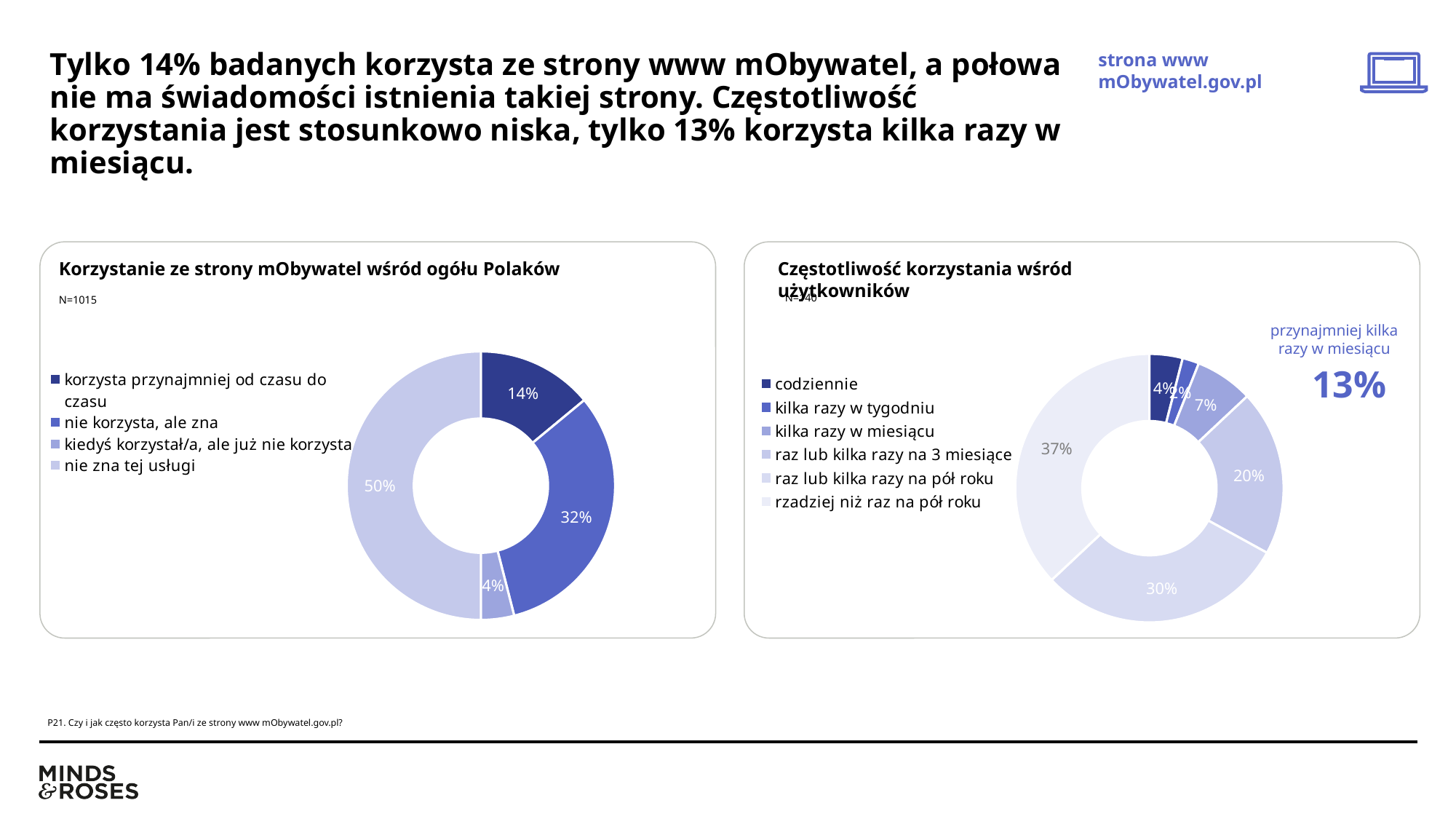
In the chart 'Korzystanie ze strony mObywatel wśród ogółu Polaków', what is the difference between 'nie korzysta, ale zna' and 'korzysta przynajmniej od czasu do czasu'? 18 percentage points How many categories does the legend of the chart 'Częstotliwość korzystania wśród użytkowników' list? 6 In the chart 'Korzystanie ze strony mObywatel wśród ogółu Polaków', what is the value for 'nie korzysta, ale zna'? 32% In the chart 'Częstotliwość korzystania wśród użytkowników', what is the value for 'rzadziej niż raz na pół roku'? 37% In the chart 'Częstotliwość korzystania wśród użytkowników', what is the value for 'raz lub kilka razy na 3 miesiące'? 20% In the chart 'Korzystanie ze strony mObywatel wśród ogółu Polaków', which category has the smallest share? kiedyś korzystał/a, ale już nie korzysta In the chart 'Korzystanie ze strony mObywatel wśród ogółu Polaków', what share of respondents 'nie zna tej usługi'? 50% In the chart 'Częstotliwość korzystania wśród użytkowników', which is larger: 'raz lub kilka razy na pół roku' or 'raz lub kilka razy na 3 miesiące'? raz lub kilka razy na pół roku How many categories does the legend of the chart 'Korzystanie ze strony mObywatel wśród ogółu Polaków' list? 4 What type of chart is used in 'Korzystanie ze strony mObywatel wśród ogółu Polaków'? Donut (pie) chart What percentage is highlighted next to the chart 'Częstotliwość korzystania wśród użytkowników' for 'przynajmniej kilka razy w miesiącu'? 13% In the chart 'Częstotliwość korzystania wśród użytkowników', which category has the largest share? rzadziej niż raz na pół roku